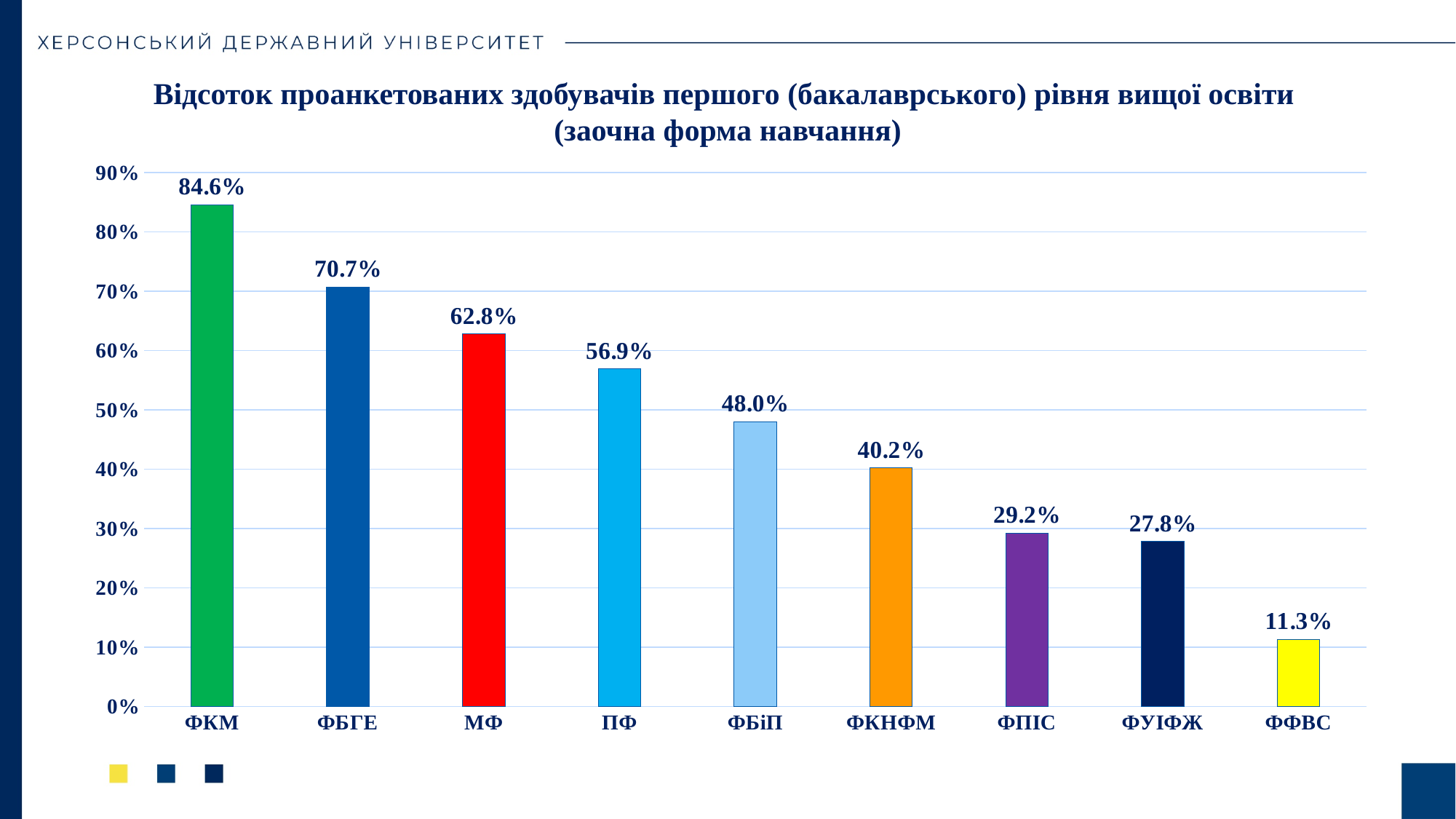
Which category has the highest value? ФКМ What is the difference between the values for ФБГЕ and МФ? 7.9% Which category has the lowest value? ФФВС What kind of chart is shown on the slide? bar chart What colour is the bar for ФФВС? yellow Is the value for ФПІС greater or less than 30%? less How many categories are shown on the x axis? 9 Do the values rise or fall from left to right along the x axis? fall What is the value for ФУІФЖ? 27.8% What is the value for ФБіП? 48.0% What is the value for ФКМ? 84.6% Which is larger, the value for ПФ or the value for ФКНФМ? ПФ